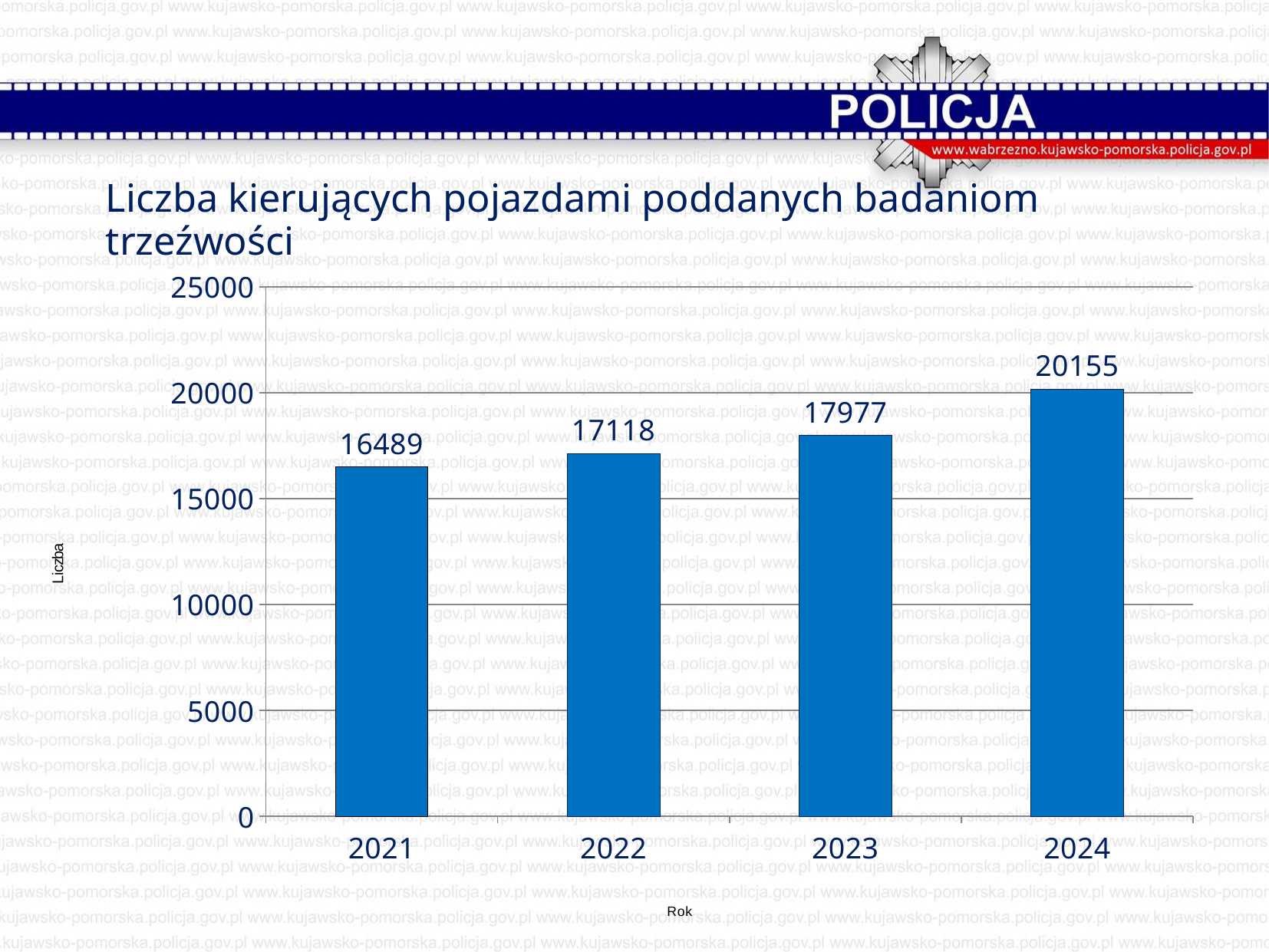
Which is larger, the value for 2022 or the value for 2023? 2023 Do the values rise or fall from 2021 to 2024? rise What is the value for 2024? 20155 What kind of chart is shown on the slide? bar chart How many years are shown on the x axis? 4 Is the value for 2024 greater or less than 20000? greater Which year has the lowest value? 2021 Which year has the highest value? 2024 What is the value for 2023? 17977 What is the difference between the values for 2024 and 2021? 3666 What is the difference between the values for 2022 and 2021? 629 What is the value for 2021? 16489